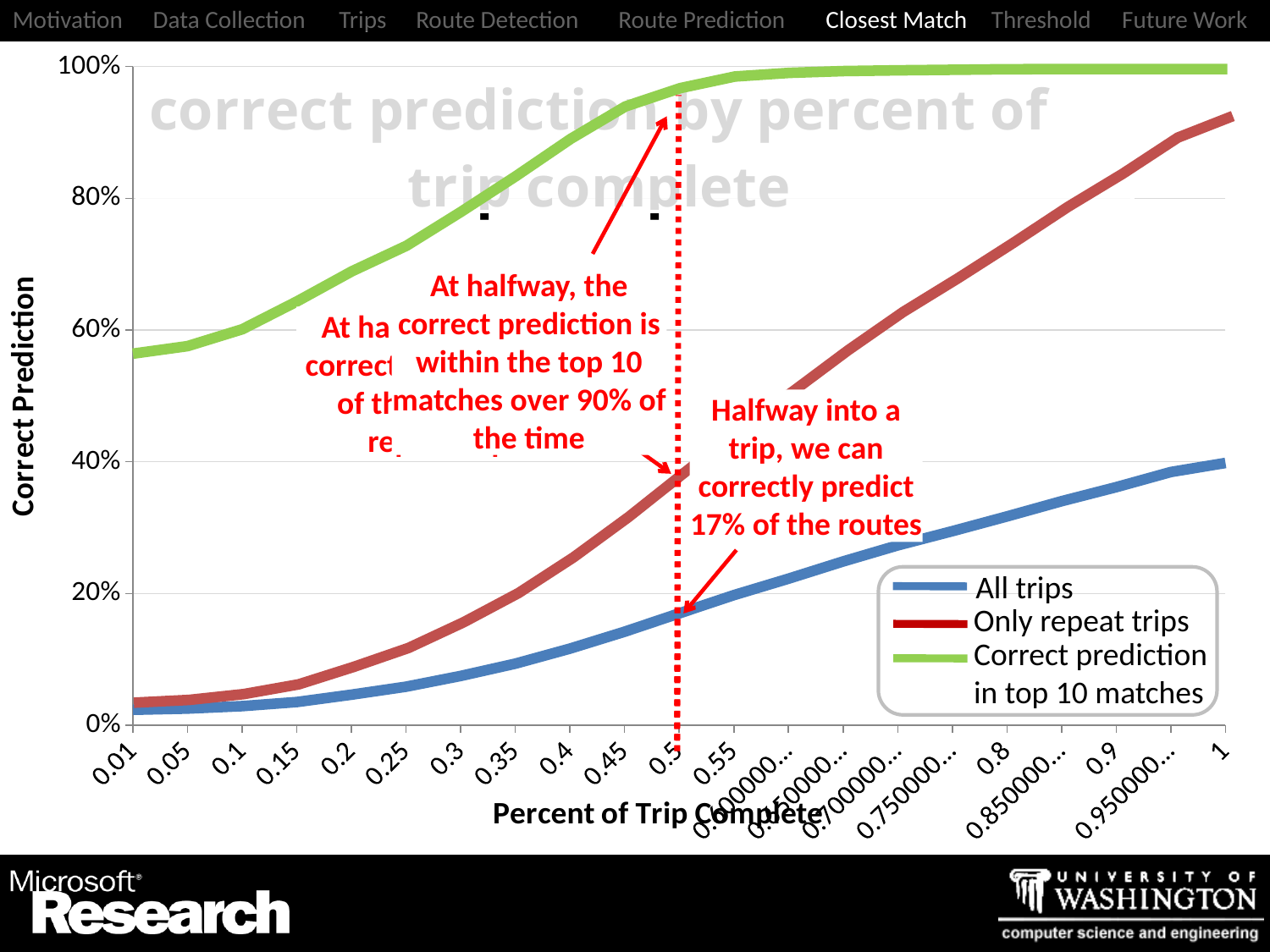
What is the label of the y axis? Correct Prediction Do the values for 'All trips' rise or fall as the percent of trip complete increases? rise Is the value for 'Correct prediction in top 10 matches' at 0.01 greater or less than 40%? greater What is the label of the x axis? Percent of Trip Complete Is the value for 'Only repeat trips' at 0.5 greater or less than 20%? greater Is the value for 'Only repeat trips' at 1 greater or less than 80%? greater Which series has the highest value at 1 on the x axis? Correct prediction in top 10 matches At 0.5 on the x axis, which is larger: 'All trips' or 'Only repeat trips'? Only repeat trips What kind of chart is shown on the slide? line chart How many series does the legend list? 3